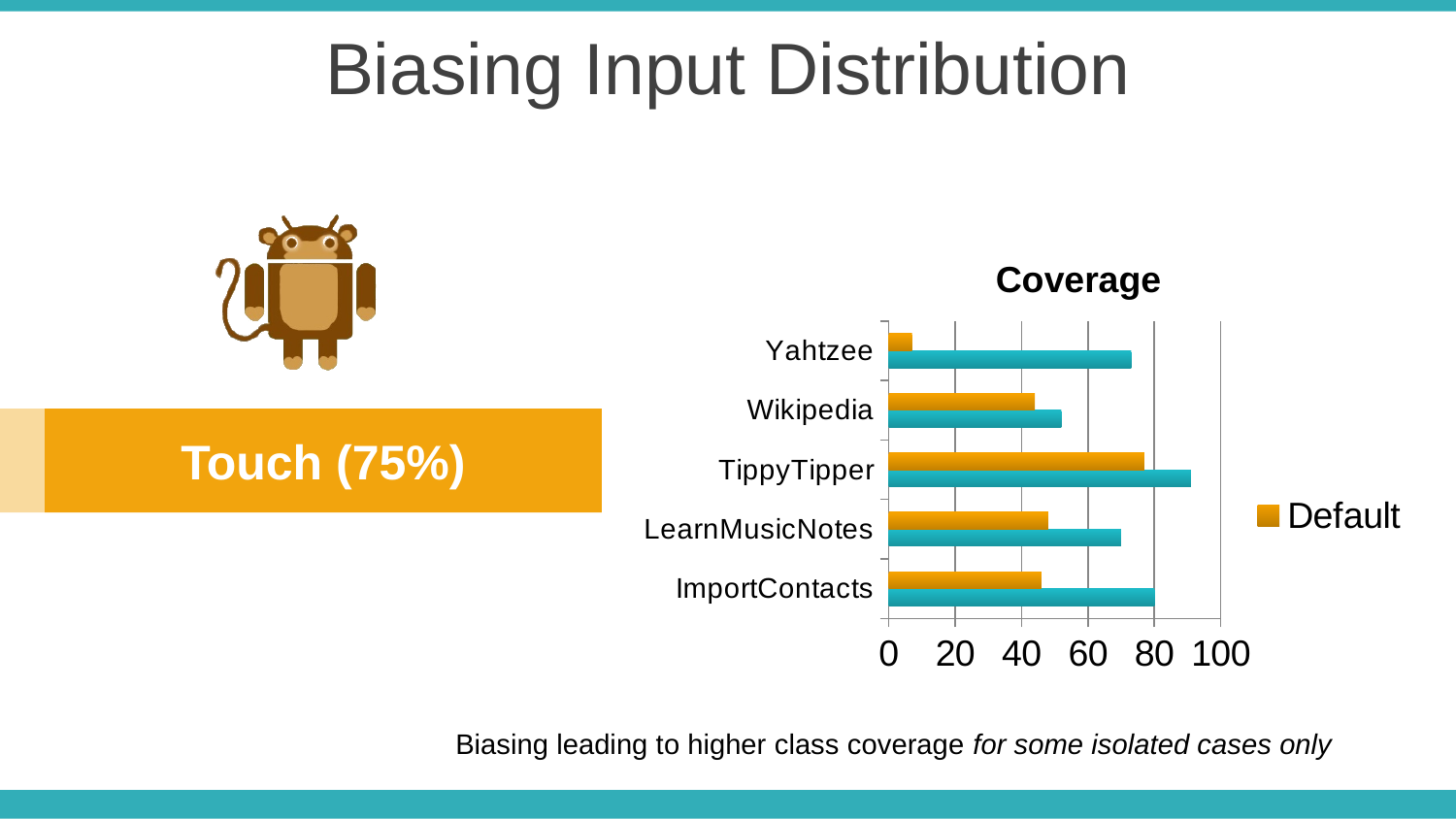
Is the Default value for Wikipedia greater or less than 60? less How many categories (apps) are shown on the Coverage chart? 5 How many entries does the legend of the Coverage chart list? 1 What is the name of the series listed in the chart's legend? Default Which has the larger Default value, TippyTipper or Wikipedia? TippyTipper Is the Default value for TippyTipper greater or less than 60? greater Which category has the lowest Default value in the Coverage chart? Yahtzee Is the teal bar for TippyTipper greater or less than 80? greater What kind of chart is the Coverage chart? bar chart Which category has the highest Default value in the Coverage chart? TippyTipper What is the title of the chart on the slide? Coverage